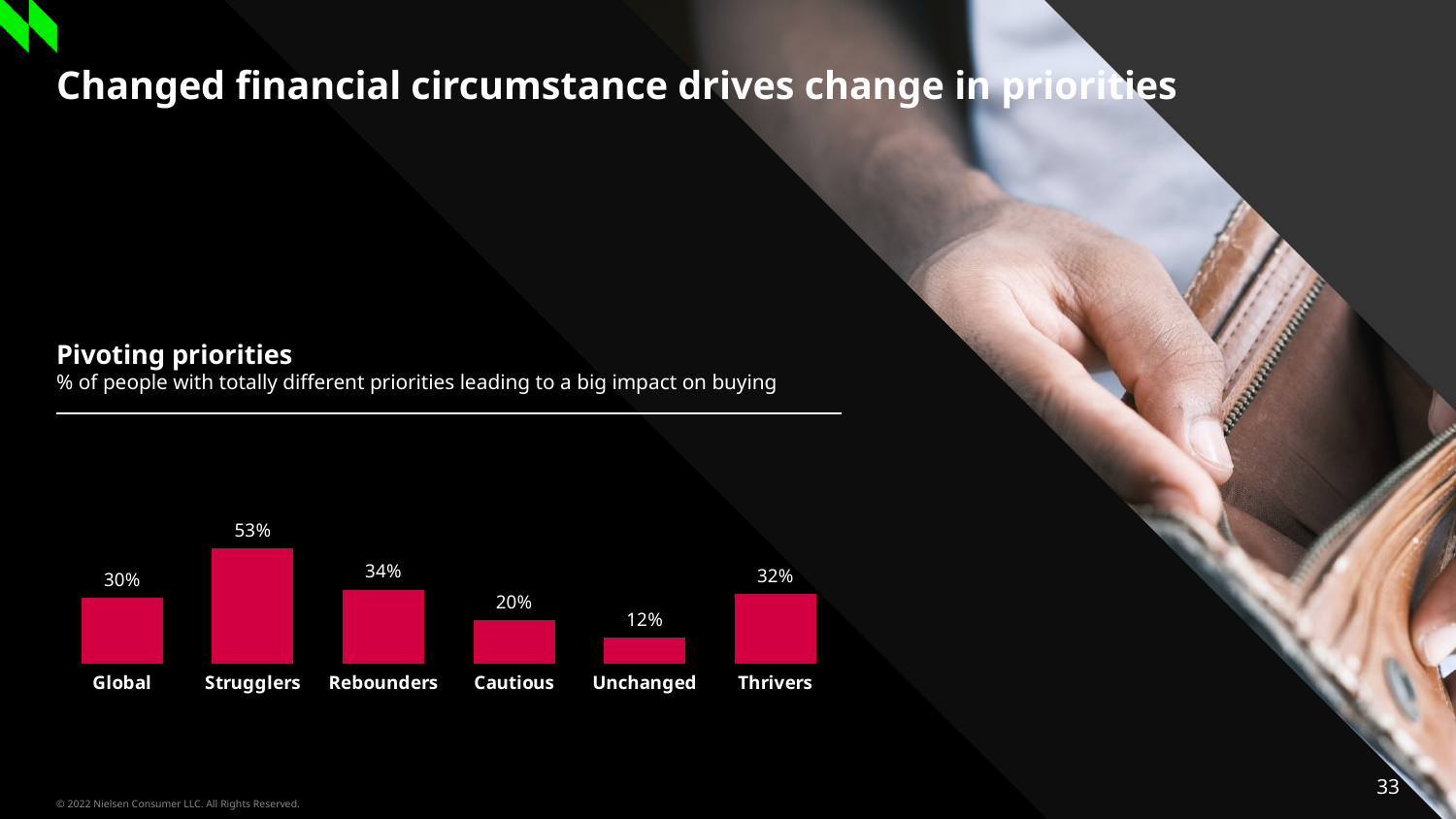
What is the value for Strugglers? 53% How many categories are shown in the chart? 6 What is the difference between the values for Cautious and Unchanged? 8% Which category has the highest value? Strugglers What is the title of the chart? Pivoting priorities What is the value for Thrivers? 32% Which category has the lowest value? Unchanged What is the value for Global? 30% What kind of chart is shown on the slide? Bar chart What is the difference between the values for Strugglers and Rebounders? 19% What is the value for Unchanged? 12% Which is larger, the value for Rebounders or the value for Thrivers? Rebounders